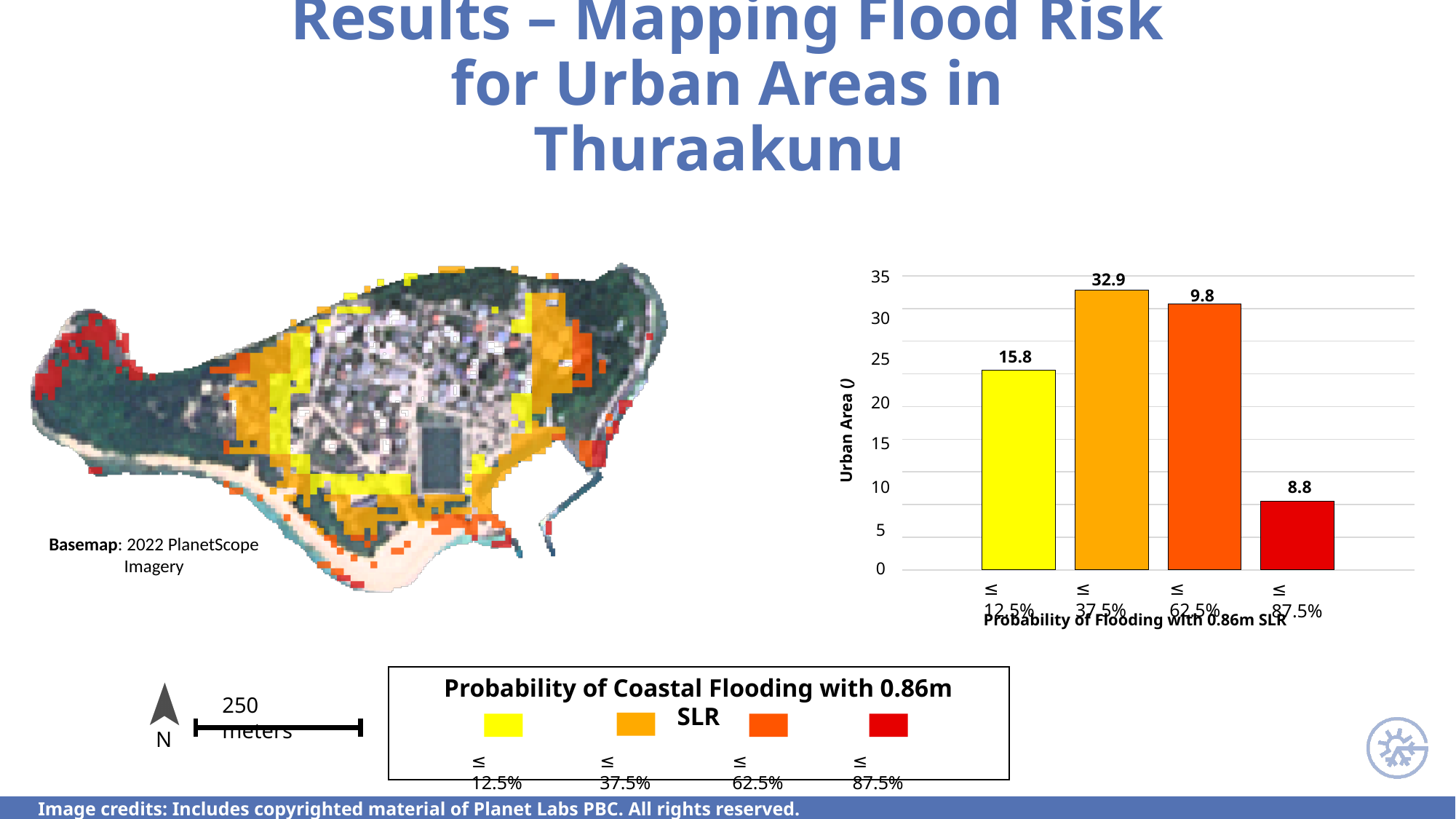
What is the urban area value labelled on the ≤ 62.5% bar? 9.8 What is the urban area value labelled on the ≤ 12.5% bar? 15.8 Which flooding probability category has the lowest urban area value? ≤ 87.5% How many flooding probability categories are shown in the bar chart? 4 What is the urban area value for the ≤ 37.5% flooding probability category? 32.9 Which has a larger urban area value, the ≤ 37.5% category or the ≤ 87.5% category? ≤ 37.5% What is the urban area value for the ≤ 87.5% flooding probability category? 8.8 Which flooding probability category has the highest urban area value? ≤ 37.5% What is the difference between the labelled values for the ≤ 37.5% and ≤ 87.5% categories? 24.1 What is the title of the x axis of the bar chart? Probability of Flooding with 0.86m SLR What colour is the bar for the ≤ 87.5% category? Red What type of chart is used to show urban area by flooding probability? Bar chart